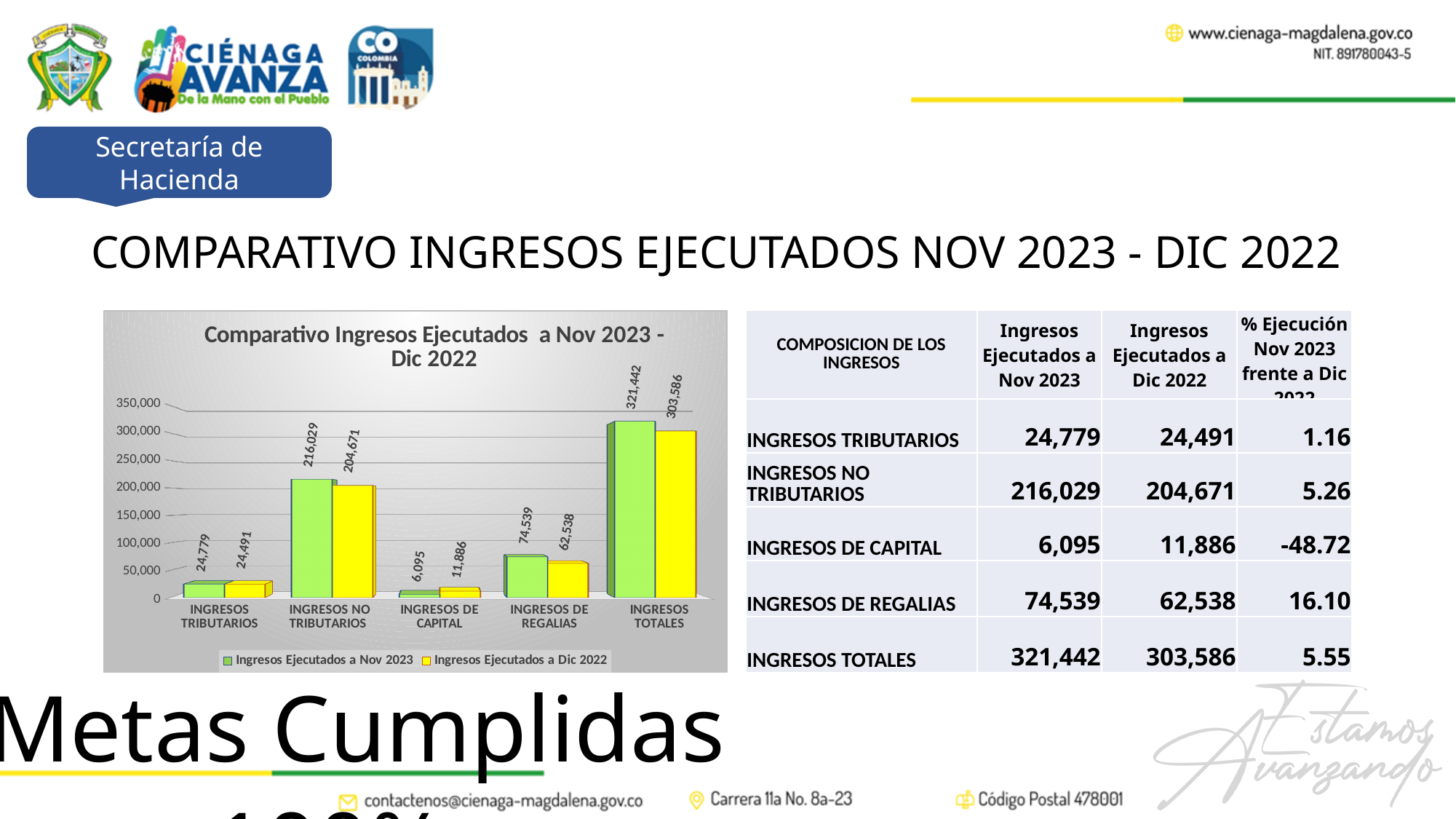
What is the difference between Ingresos Ejecutados a Nov 2023 and Ingresos Ejecutados a Dic 2022 for INGRESOS TOTALES? 17,856 How many series does the chart legend list? 2 What is the value of Ingresos Ejecutados a Nov 2023 for INGRESOS DE CAPITAL? 6,095 For INGRESOS DE CAPITAL, which is larger: Ingresos Ejecutados a Nov 2023 or Ingresos Ejecutados a Dic 2022? Ingresos Ejecutados a Dic 2022 Which category has the highest value for Ingresos Ejecutados a Dic 2022? INGRESOS TOTALES What kind of chart is shown on the slide? Bar chart How many categories are shown on the x axis of the chart? 5 What is the value of Ingresos Ejecutados a Nov 2023 for INGRESOS NO TRIBUTARIOS? 216,029 Which category has the lowest value for Ingresos Ejecutados a Nov 2023? INGRESOS DE CAPITAL What colour are the bars for Ingresos Ejecutados a Dic 2022 in the chart? Yellow What is the value of Ingresos Ejecutados a Dic 2022 for INGRESOS DE REGALIAS? 62,538 Is the value of Ingresos Ejecutados a Nov 2023 for INGRESOS DE REGALIAS greater or less than 100,000? less